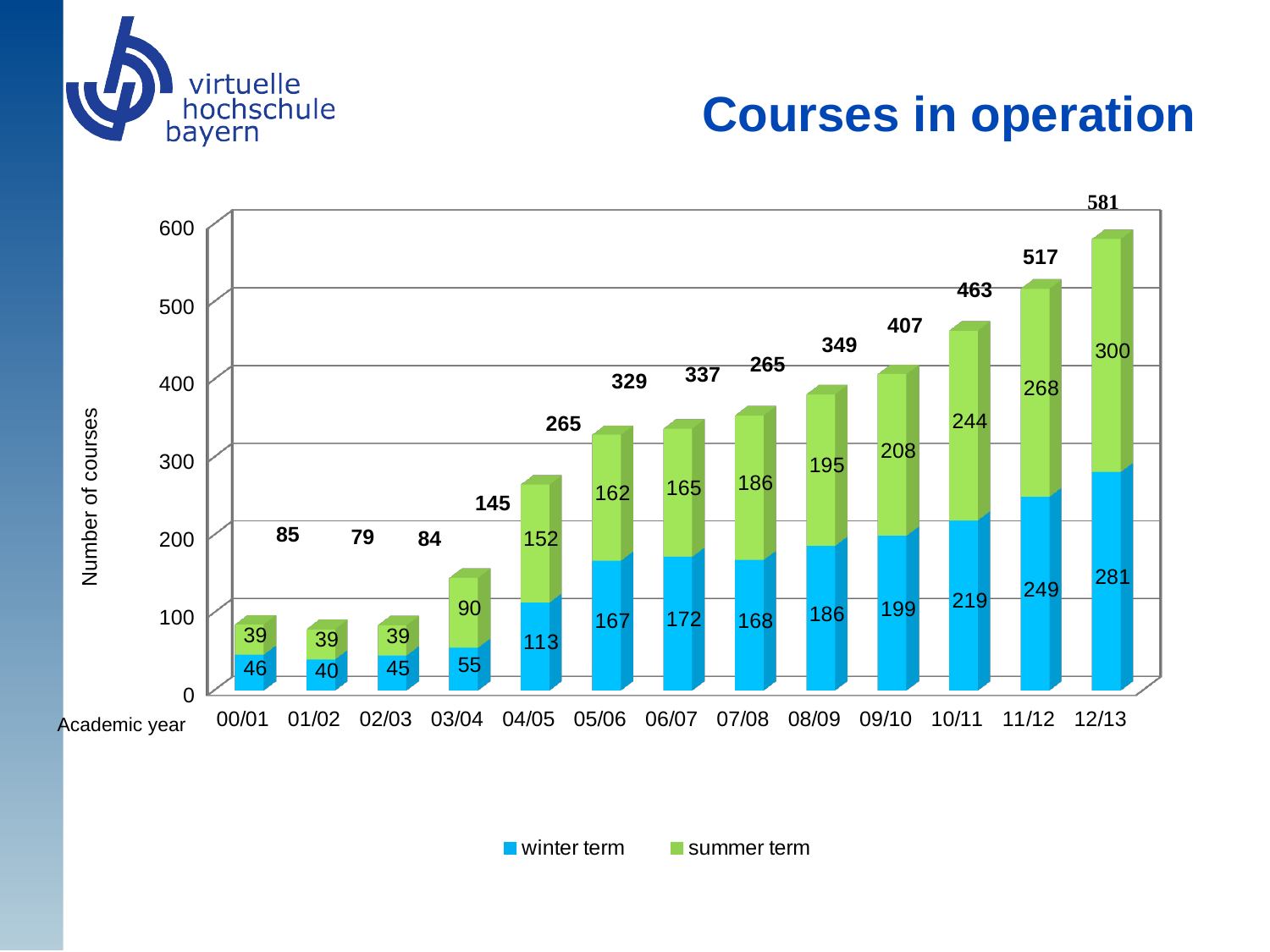
What kind of chart is shown on the slide? stacked bar chart What is the title of the chart? Courses in operation What is the difference between the summer term and winter term values for 12/13? 19 What is the total number of courses for 09/10? 407 Which is larger for 05/06, the winter term value or the summer term value? winter term How many series does the legend list? 2 What is the winter term value for 04/05? 113 How many academic years are shown on the x axis? 13 Is the total for 10/11 greater or less than 400? greater Which academic year has the highest total number of courses? 12/13 Which academic year has the lowest total number of courses? 01/02 What is the summer term value for 11/12? 268